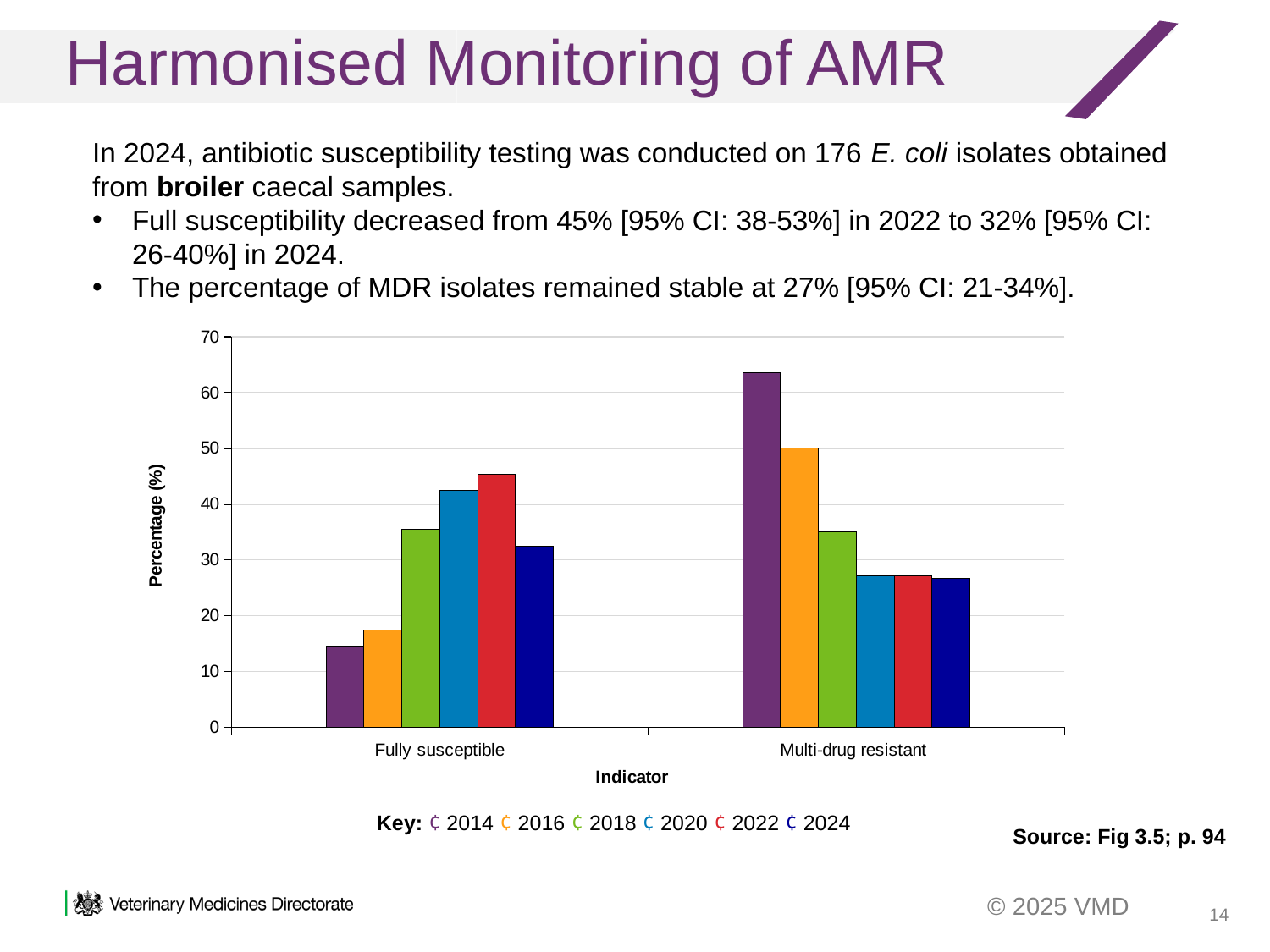
Which year has the lowest Fully susceptible value? 2014 For Multi-drug resistant, which is larger: the 2014 value or the 2016 value? 2014 What kind of chart is shown on the slide? bar chart Is the Fully susceptible value for 2016 greater or less than 20? less How many years does the key list for the chart? 6 Is the Multi-drug resistant value for 2024 greater or less than 30? less What is the label on the y axis of the chart? Percentage (%) Is the Multi-drug resistant value for 2014 greater or less than 60? greater How many indicator categories are shown on the x axis of the chart? 2 Which year has the highest Multi-drug resistant value? 2014 Does the Multi-drug resistant percentage generally rise or fall from 2014 to 2024? fall Which year has the highest Fully susceptible value? 2022